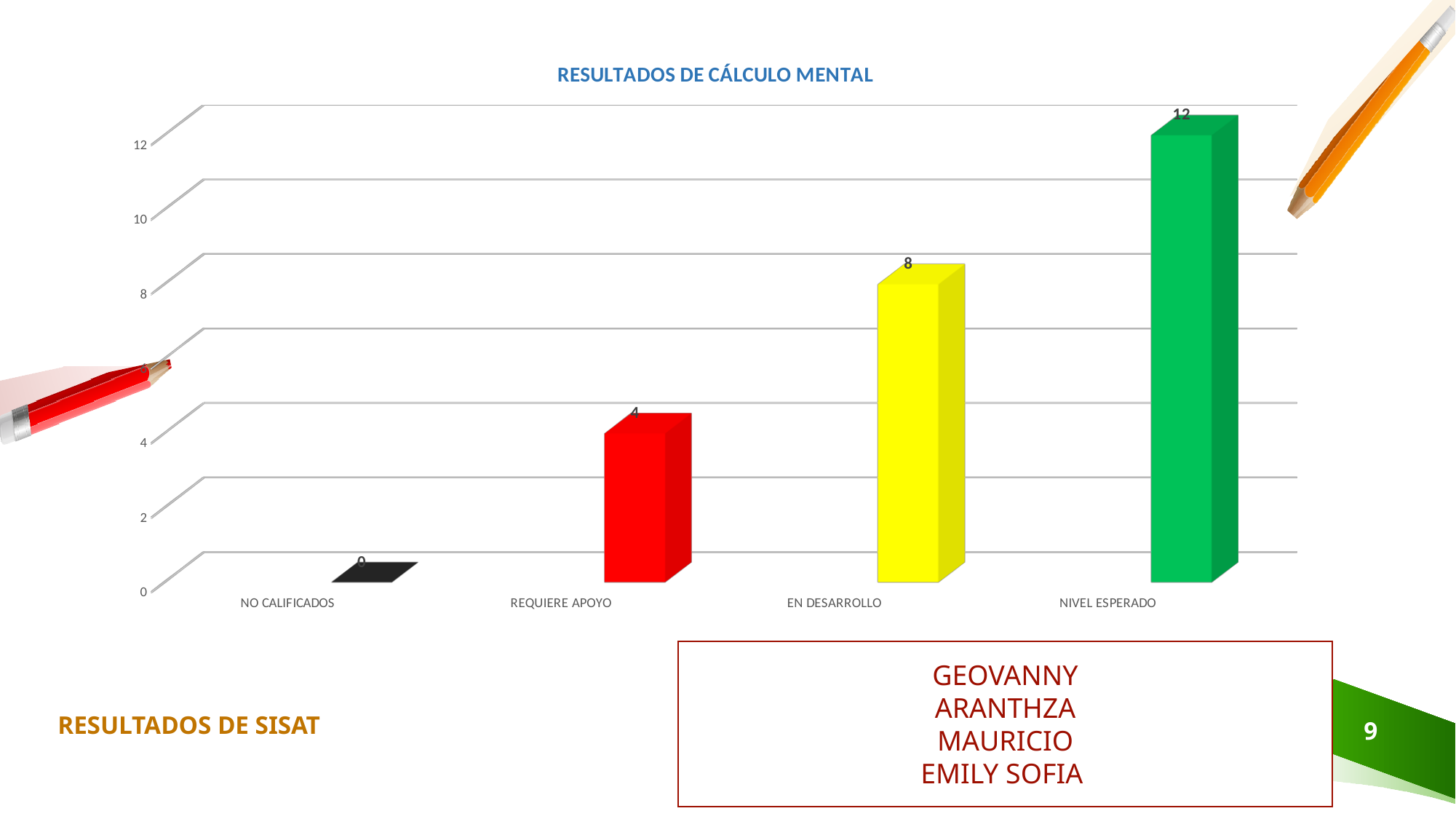
Which is larger, the value for REQUIERE APOYO or the value for EN DESARROLLO? EN DESARROLLO What is the title of the chart? RESULTADOS DE CÁLCULO MENTAL Do the values rise or fall from left to right along the x axis? Rise What kind of chart is shown on the slide? Bar chart Which category has the lowest value? NO CALIFICADOS What is the value for NIVEL ESPERADO? 12 Which category has the highest value? NIVEL ESPERADO What is the difference between the values for NIVEL ESPERADO and EN DESARROLLO? 4 How many categories are shown on the x axis? 4 What is the value for REQUIERE APOYO? 4 What is the value for NO CALIFICADOS? 0 What is the value for EN DESARROLLO? 8